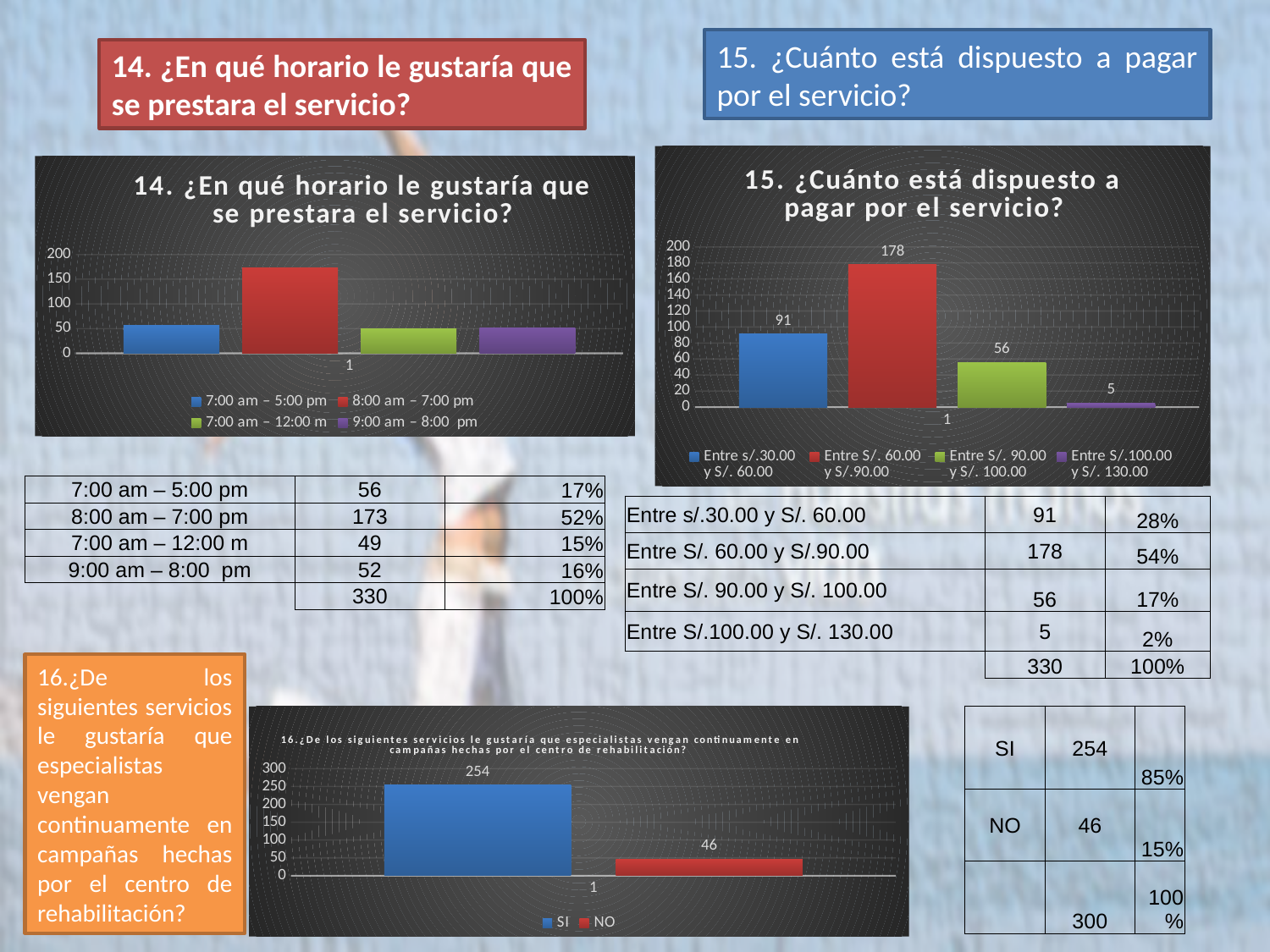
In the chart titled "14. ¿En qué horario le gustaría que se prestara el servicio?", which series has the highest value? 8:00 am – 7:00 pm In the bottom chart about question 16, what is the value for "SI"? 254 In the chart titled "15. ¿Cuánto está dispuesto a pagar por el servicio?", what is the value for "Entre S/.100.00 y S/. 130.00"? 5 In the chart titled "14. ¿En qué horario le gustaría que se prestara el servicio?", is the value for "8:00 am – 7:00 pm" greater or less than 150? greater How many series does the legend list in the chart titled "15. ¿Cuánto está dispuesto a pagar por el servicio?"? 4 In the chart titled "15. ¿Cuánto está dispuesto a pagar por el servicio?", what is the difference between the values for "Entre s/.30.00 y S/. 60.00" and "Entre S/. 90.00 y S/. 100.00"? 35 In the bottom chart about question 16, what is the difference between the values for "SI" and "NO"? 208 In the chart titled "15. ¿Cuánto está dispuesto a pagar por el servicio?", which series has the lowest value? Entre S/.100.00 y S/. 130.00 What kind of chart is the chart titled "14. ¿En qué horario le gustaría que se prestara el servicio?"? bar chart In the bottom chart about question 16, which is larger, "SI" or "NO"? SI In the chart titled "14. ¿En qué horario le gustaría que se prestara el servicio?", is the value for "7:00 am – 12:00 m" greater or less than 100? less In the chart titled "15. ¿Cuánto está dispuesto a pagar por el servicio?", what is the value for "Entre S/. 60.00 y S/.90.00"? 178